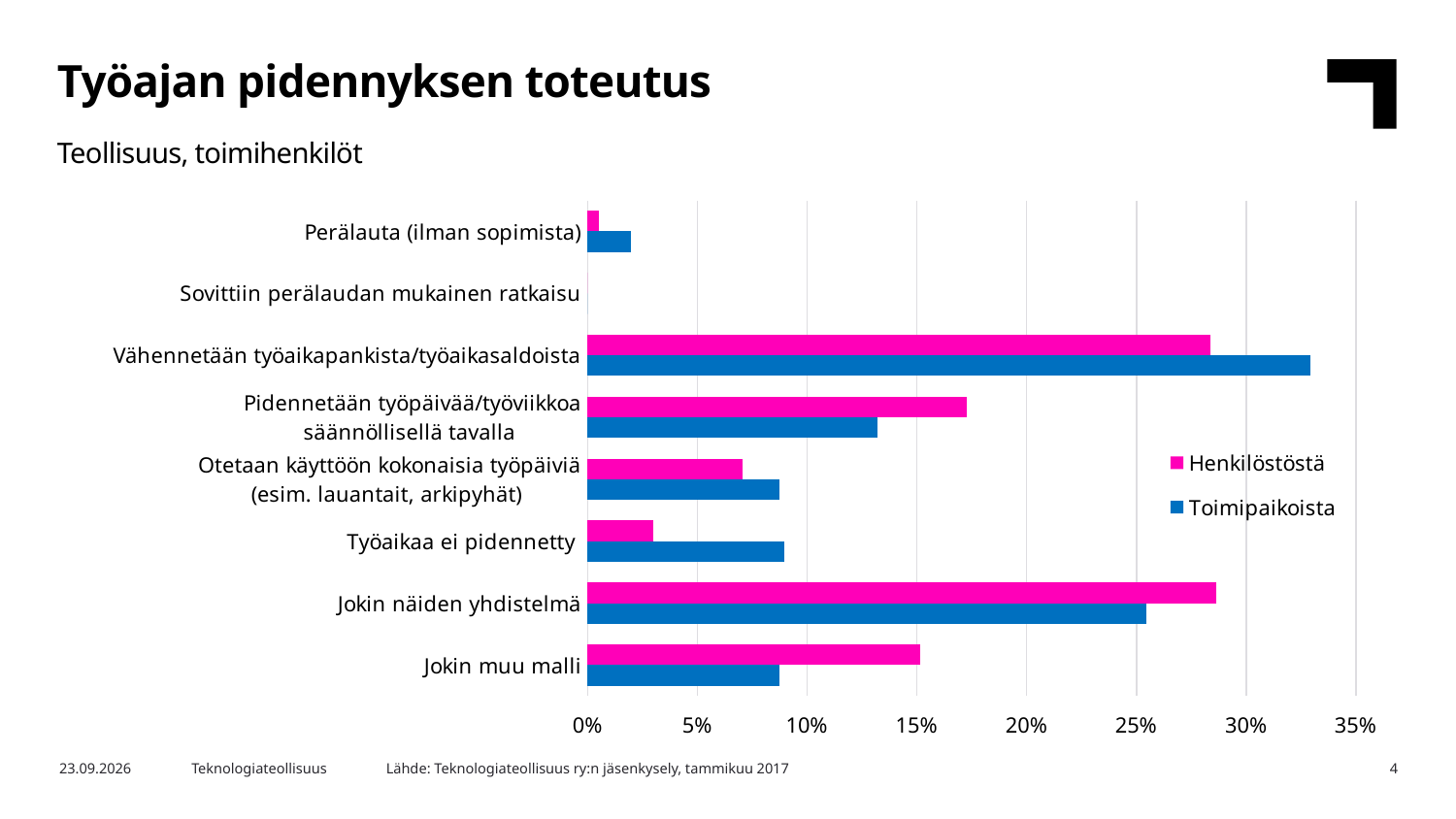
Which colour represents the Toimipaikoista series? blue For Jokin muu malli, which series has the larger value, Henkilöstöstä or Toimipaikoista? Henkilöstöstä Is the Toimipaikoista value for Jokin näiden yhdistelmä greater or less than 20%? greater For Pidennetään työpäivää/työviikkoa säännöllisellä tavalla, which series has the larger value, Henkilöstöstä or Toimipaikoista? Henkilöstöstä Is the Toimipaikoista value for Vähennetään työaikapankista/työaikasaldoista greater or less than 30%? greater Is the Henkilöstöstä value for Työaikaa ei pidennetty greater or less than 5%? less What kind of chart is shown on the slide? bar chart For Työaikaa ei pidennetty, which series has the larger value, Henkilöstöstä or Toimipaikoista? Toimipaikoista How many series does the legend list? 2 How many categories are shown on the chart? 8 Which category has the highest value for Toimipaikoista? Vähennetään työaikapankista/työaikasaldoista